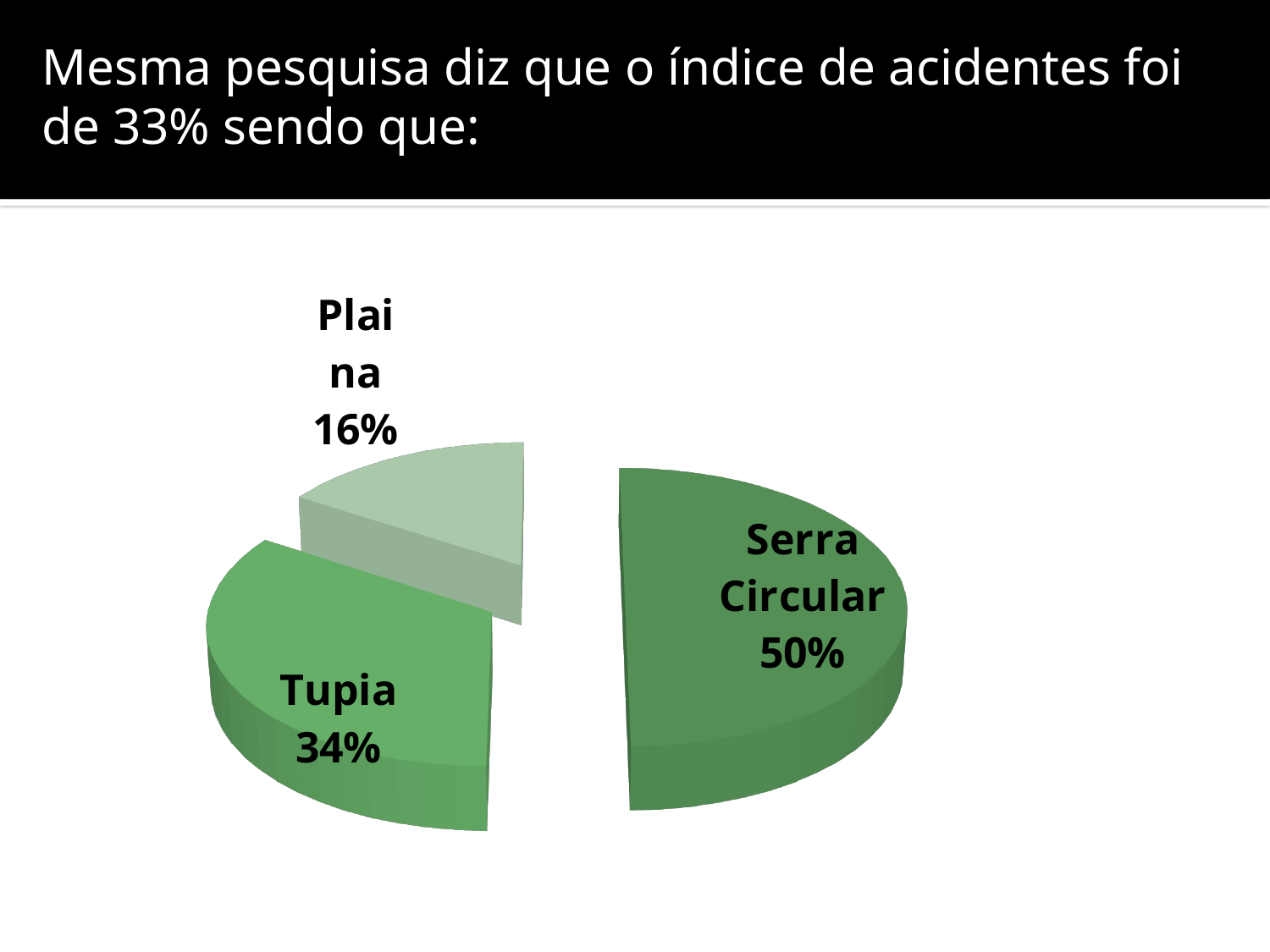
What share of the pie does Serra Circular have? 50% What share of the pie does Plaina have? 16% Which slice is shown in the lightest shade of green? Plaina What is the difference in percentage points between Serra Circular and Tupia? 16 What share of the pie does Tupia have? 34% Which category has the largest slice of the pie? Serra Circular What kind of chart is shown on the slide? Pie chart What is the difference in percentage points between Tupia and Plaina? 18 Which is larger, the share for Tupia or the share for Plaina? Tupia How many slices does the pie chart have? 3 Which is larger, the share for Serra Circular or the share for Tupia? Serra Circular Which category has the smallest slice of the pie? Plaina